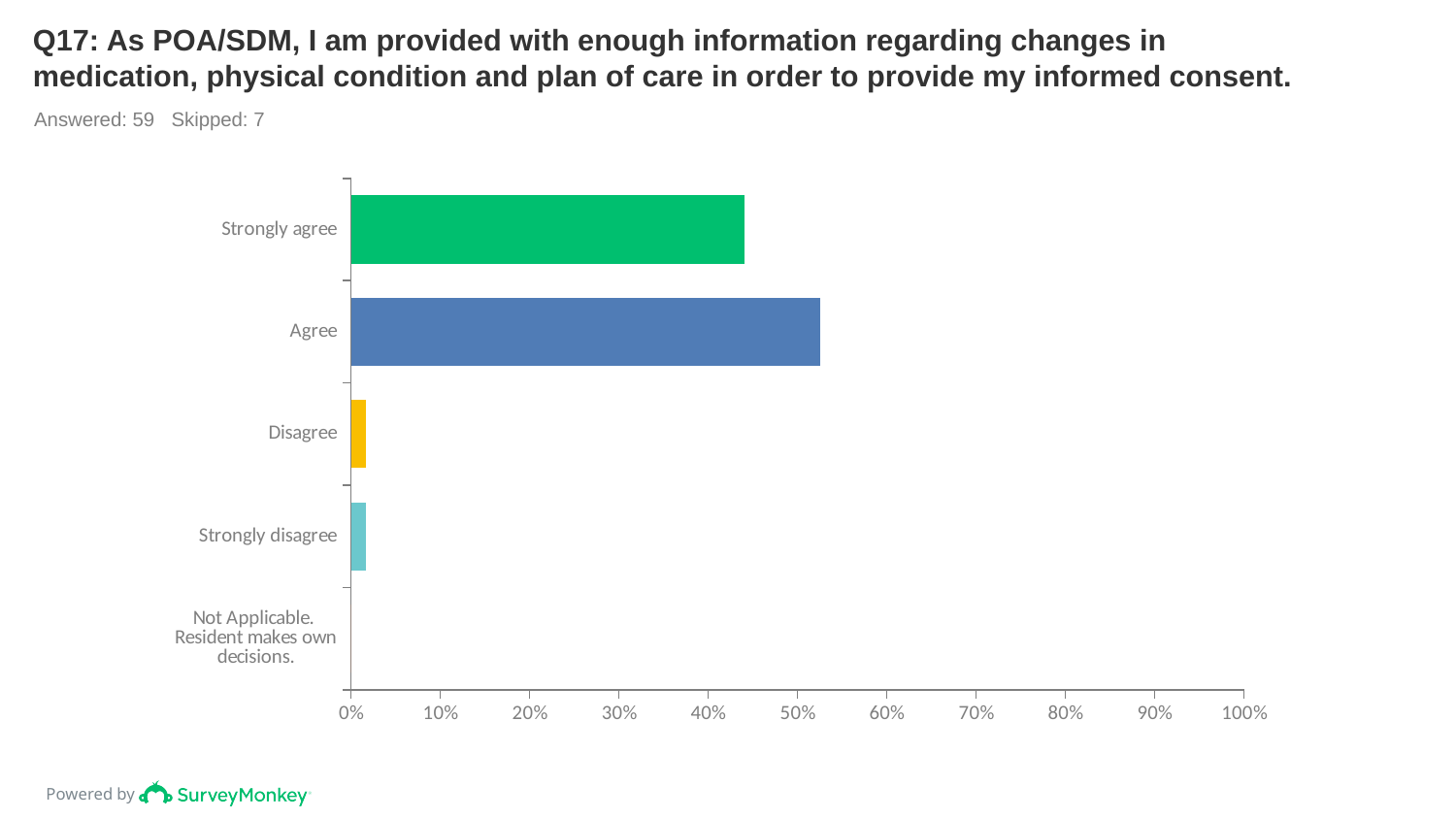
How many response categories are shown on the chart? 5 Which response category has the lowest value? Not Applicable. Resident makes own decisions. Which response category has the highest value? Agree How many respondents answered this question according to the slide? 59 What is the maximum value shown on the horizontal axis? 100% Is the value for Disagree greater or less than 10%? less What kind of chart is shown on the slide? bar chart Is the value for Strongly agree greater or less than 50%? less Is the value for Strongly disagree greater or less than 10%? less Which is larger, the value for Agree or the value for Strongly agree? Agree